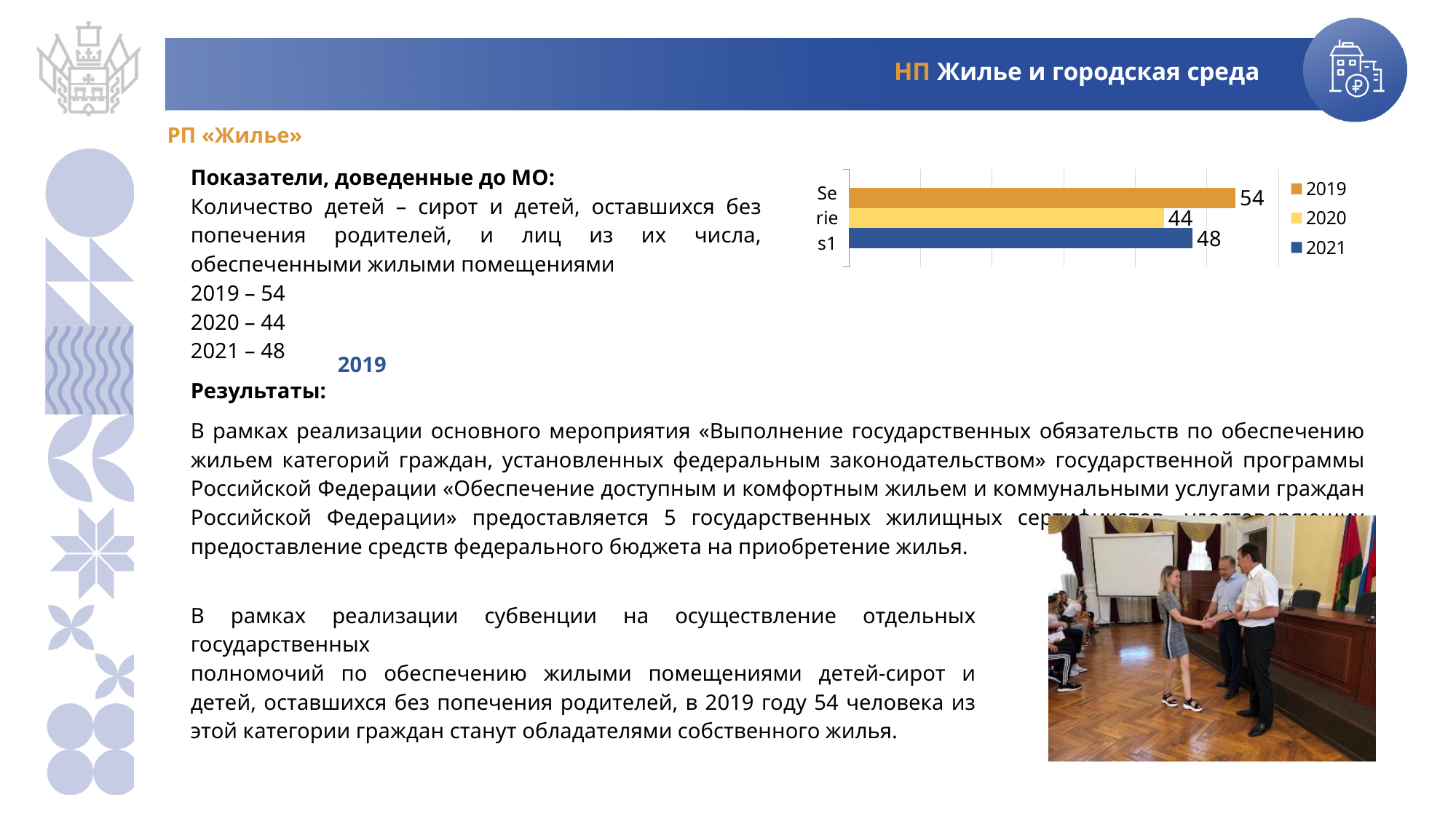
Which year has the highest value in the chart? 2019 What is the value of the 2021 bar in the chart? 48 Which is larger in the chart, the value for 2020 or the value for 2021? 2021 What colour is the 2021 bar in the chart? Blue What is the difference between the 2019 and 2020 values in the chart? 10 What is the category label shown on the vertical axis of the chart? Series1 What is the difference between the 2021 and 2020 values in the chart? 4 What is the value of the 2019 bar in the chart? 54 Which year has the lowest value in the chart? 2020 How many series does the chart legend list? 3 What kind of chart is shown on the slide? Bar chart What is the value of the 2020 bar in the chart? 44